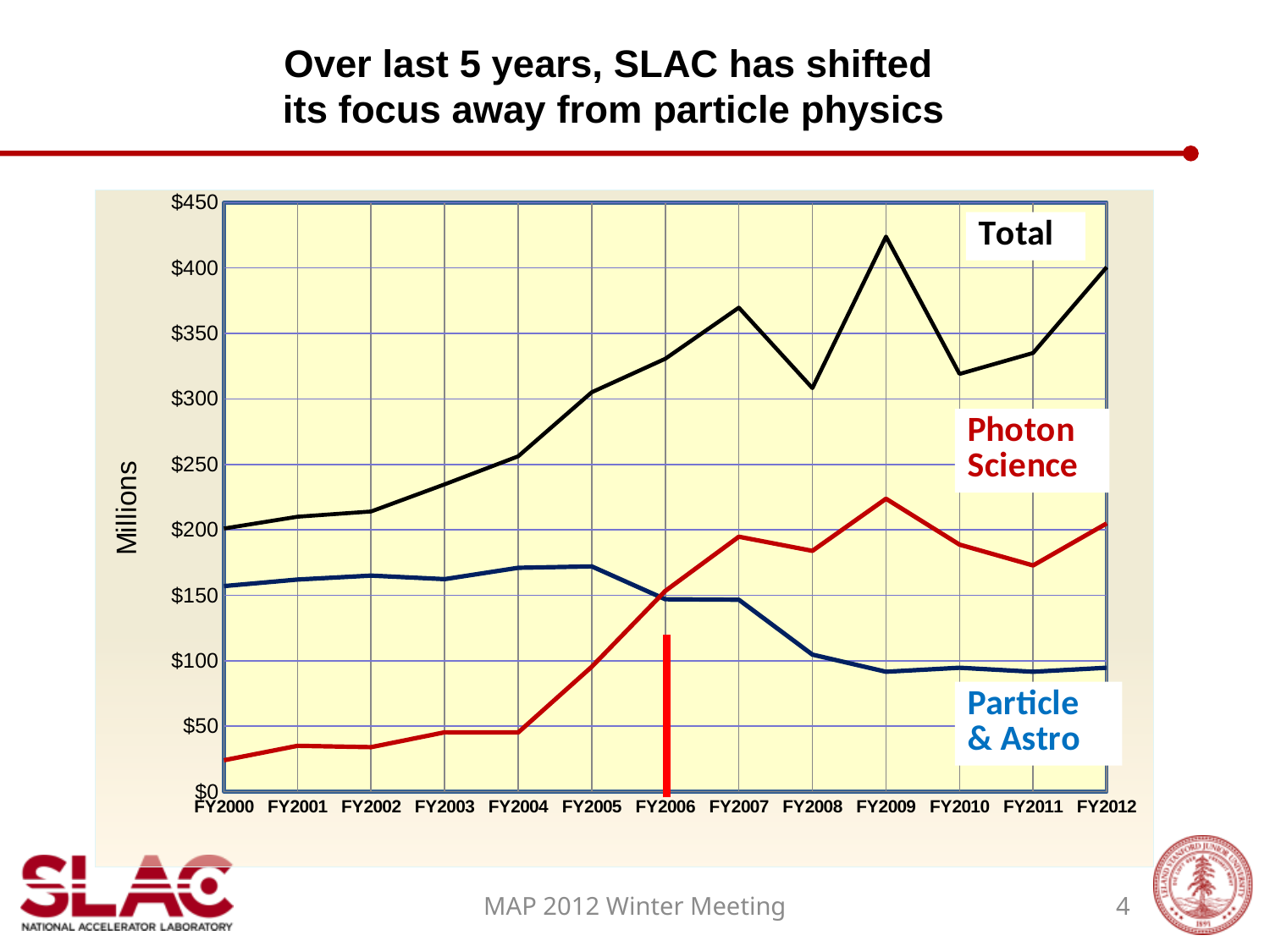
In FY2003, which is larger: Particle & Astro or Photon Science? Particle & Astro Is the Total value for FY2009 greater or less than $400? greater How many series are plotted on the chart? 3 How many fiscal years are plotted along the x axis? 13 In FY2012, which is larger: Photon Science or Particle & Astro? Photon Science In which fiscal year is the Total line at its highest? FY2009 What kind of chart is shown on the slide? line chart Is the Particle & Astro value for FY2009 greater or less than $100? less What is the label on the y axis? Millions In which fiscal year is the Total line at its lowest? FY2000 Is the Photon Science value for FY2000 greater or less than $50? less In which fiscal year does the Photon Science line reach its highest value? FY2009